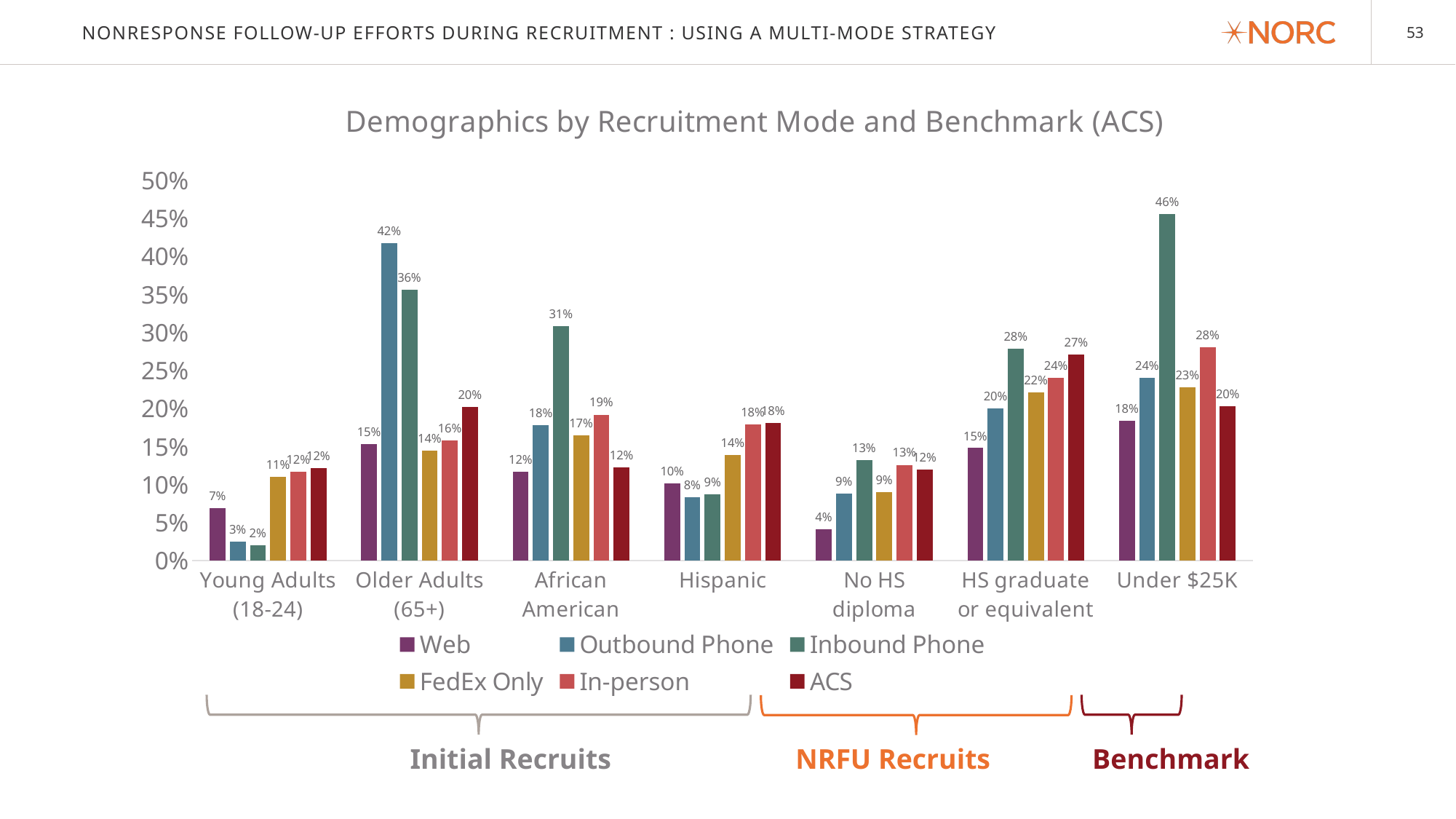
What is the Web value for No HS diploma? 4% What is the title of the chart? Demographics by Recruitment Mode and Benchmark (ACS) Which recruitment mode has the highest value for African American? Inbound Phone What is the difference between the Inbound Phone value and the ACS value for Under $25K? 26% How many demographic categories are shown on the x axis? 7 What is the Inbound Phone value for Under $25K? 46% What is the ACS value for HS graduate or equivalent? 27% How many series does the legend list? 6 What type of chart is shown on the slide? bar chart Which series has the lowest value for Young Adults (18-24)? Inbound Phone Which is larger for Hispanic: the FedEx Only value or the In-person value? In-person What is the Outbound Phone value for Older Adults (65+)? 42%